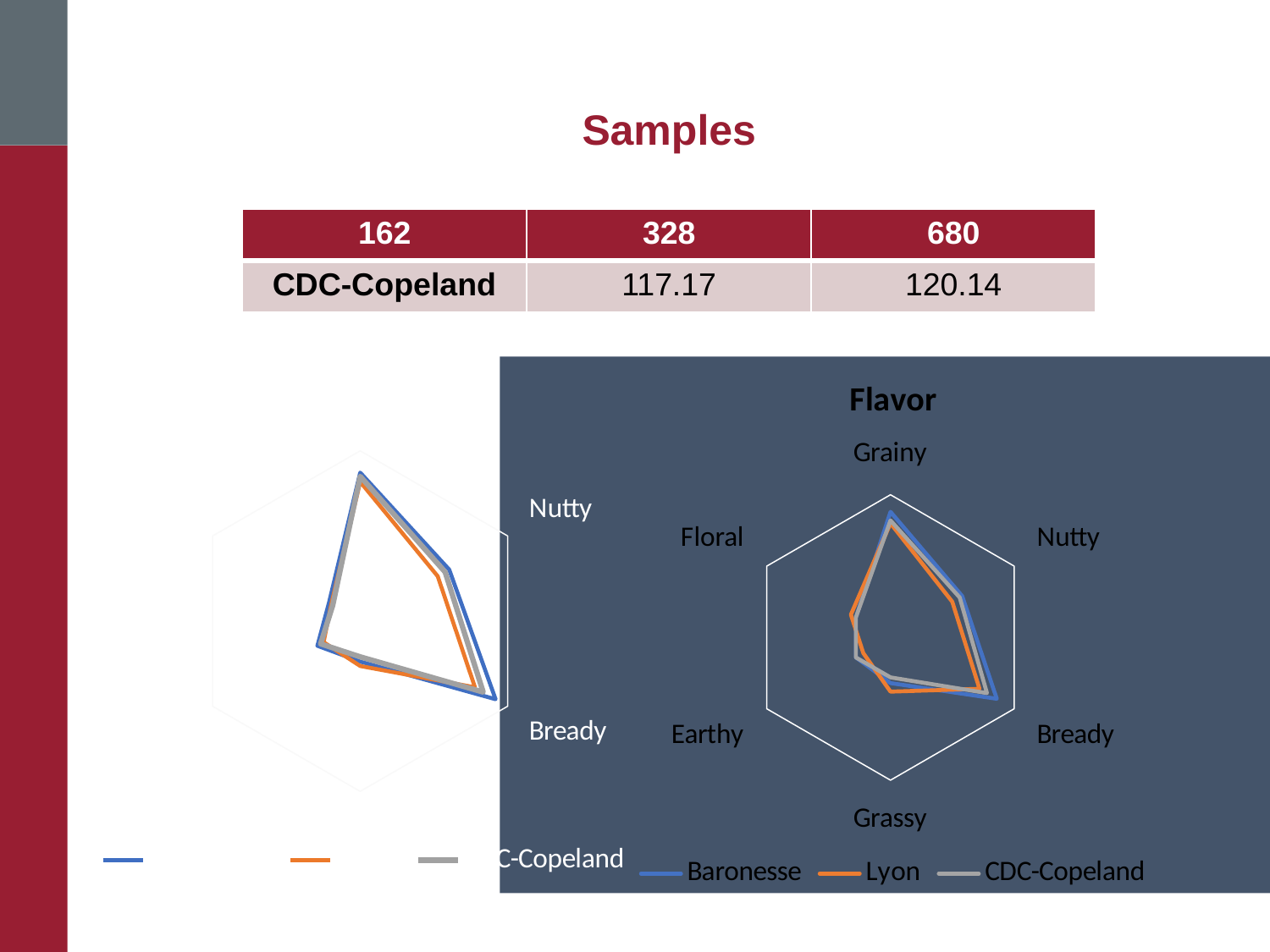
In the 'Flavor' chart, is Lyon's value for Bready larger or smaller than its value for Earthy? Larger How many flavor categories are plotted on the 'Flavor' radar chart? 6 What kind of chart is the partially visible chart on the left of the slide? Radar chart What kind of chart is the 'Flavor' chart on the right of the slide? Radar chart What is the title of the radar chart on the right of the slide? Flavor How many series does the legend of the 'Flavor' chart list? 3 Which series in the 'Flavor' chart is drawn in orange? Lyon In the 'Flavor' chart, is Baronesse's value for Grainy larger or smaller than its value for Floral? Larger In the 'Flavor' chart, is CDC-Copeland's value for Grainy larger or smaller than its value for Earthy? Larger